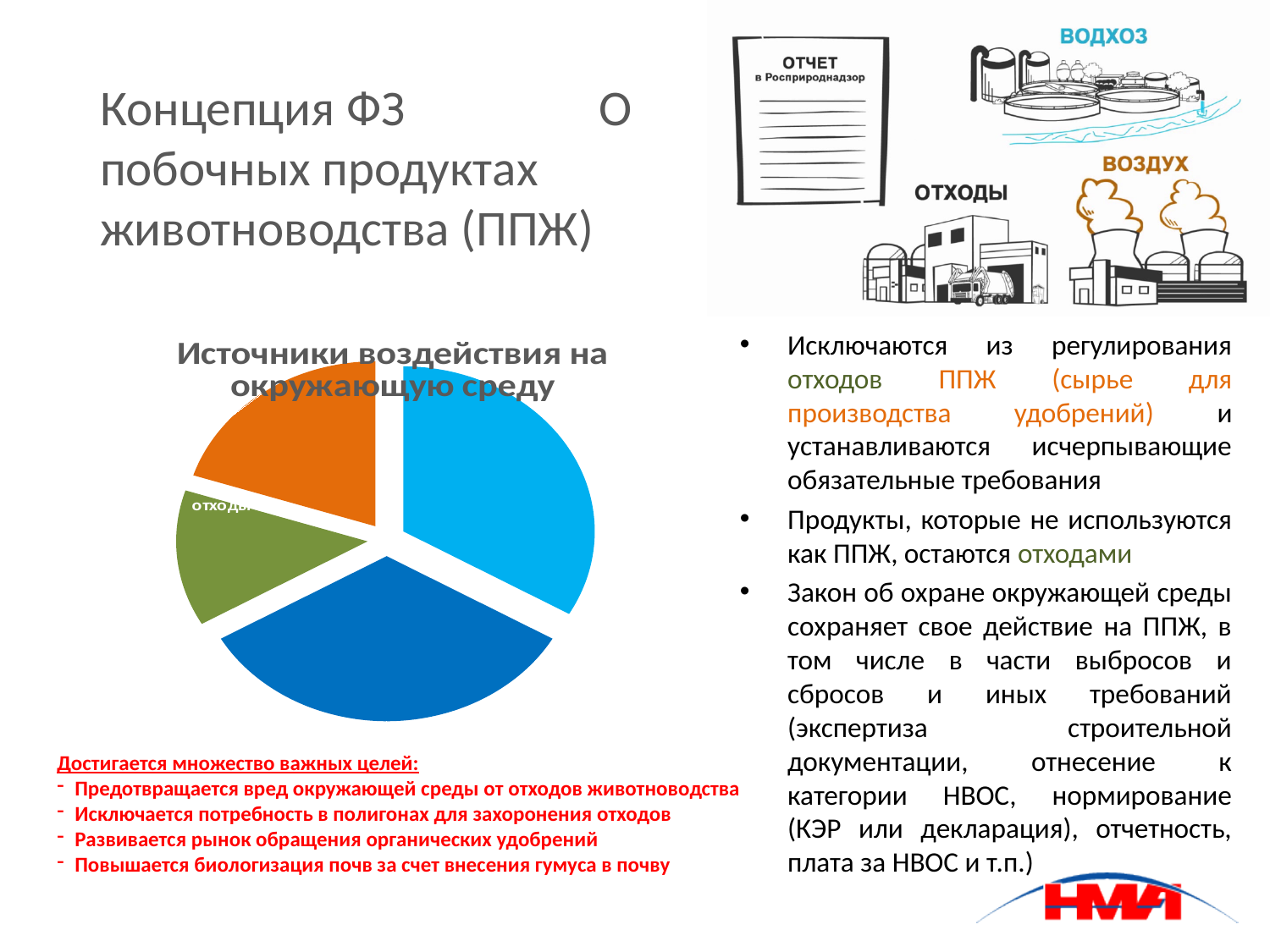
Is the slice labelled "отходы" larger or smaller than the light blue slice? smaller How many slices does the pie chart have? 4 What is the title of the pie chart? Источники воздействия на окружающую среду Which labelled slice of the pie chart is the smallest? отходы What kind of chart is shown on the slide? pie chart What colour is the slice labelled "отходы"? green